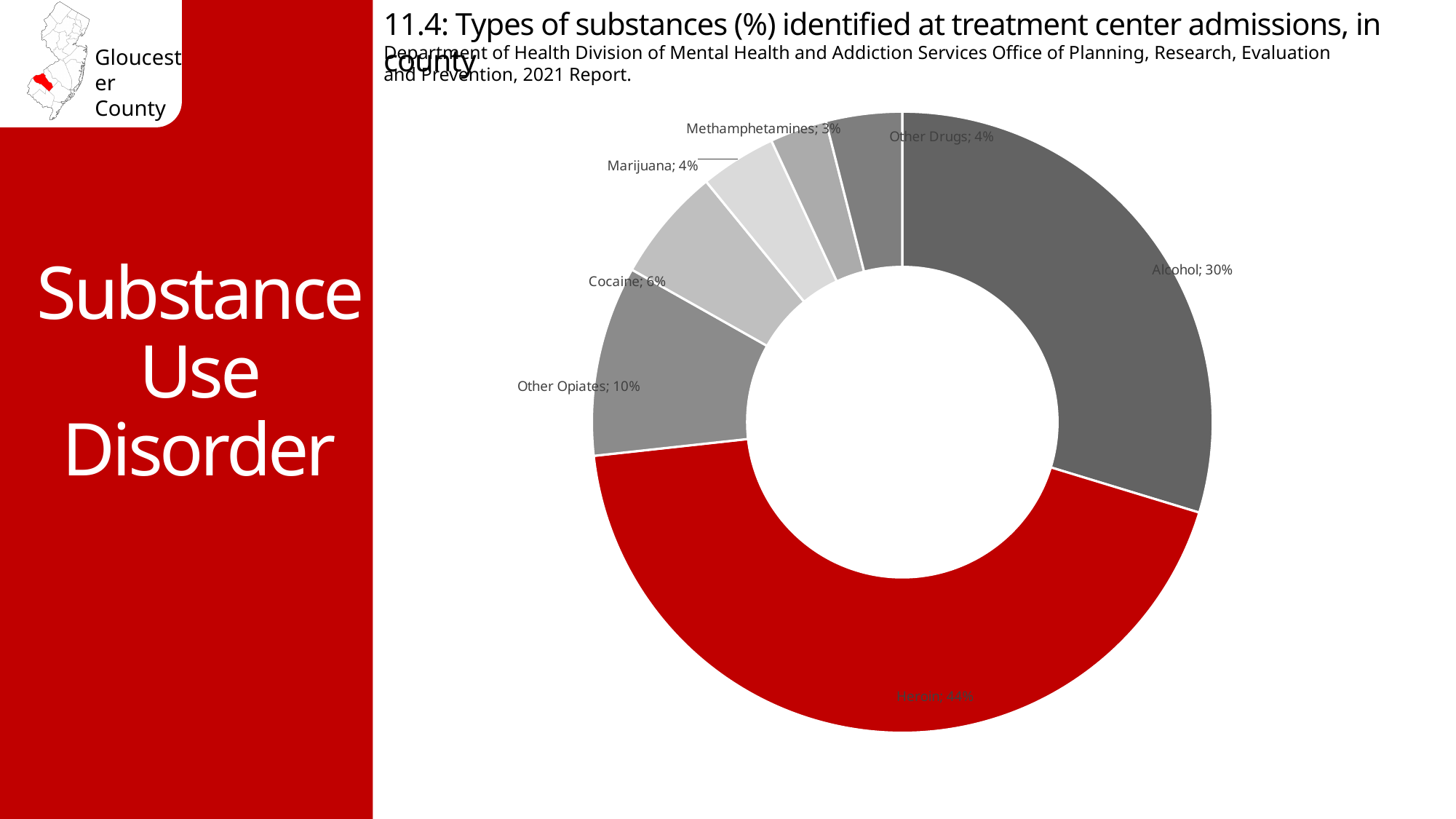
What percentage is shown for Methamphetamines? 3% What percentage of treatment center admissions identified Heroin? 44% How many percentage points higher is Heroin than Alcohol? 14 What percentage is shown for Other Opiates? 10% How many substance categories are shown in the chart? 7 Which substance has the largest share of treatment center admissions? Heroin What percentage of treatment center admissions identified Alcohol? 30% Which substance has the smallest share of treatment center admissions? Methamphetamines What kind of chart is used on this slide? Pie chart (doughnut) Which slice of the chart is coloured red? Heroin What percentage is shown for Cocaine? 6% Which has a larger share, Other Opiates or Cocaine? Other Opiates